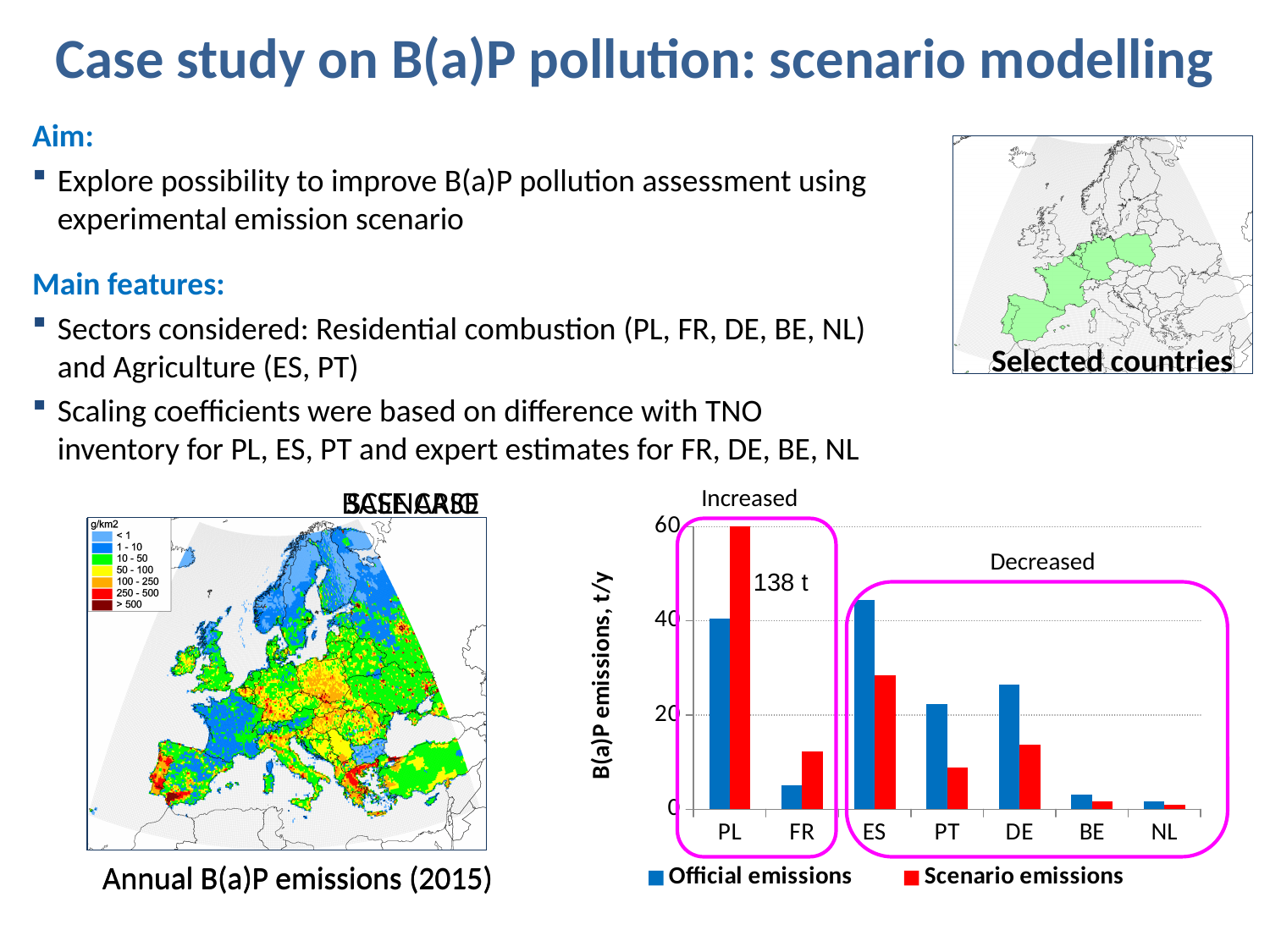
What kind of chart is shown on the right of the slide? bar chart What is the y-axis title of the bar chart? B(a)P emissions, t/y Is the Official emissions value for PT greater or less than 40? less Which country has the highest Scenario emissions in the bar chart? PL For ES, which is larger: Official emissions or Scenario emissions? Official emissions What value is annotated next to the PL Scenario emissions bar? 138 t For PL, which is larger: Official emissions or Scenario emissions? Scenario emissions Is the Official emissions value for ES greater or less than 40? greater How many series does the legend of the bar chart list? 2 Which country has the lowest Official emissions in the bar chart? NL How many countries are shown on the x axis of the bar chart? 7 Is the Scenario emissions value for DE greater or less than 20? less